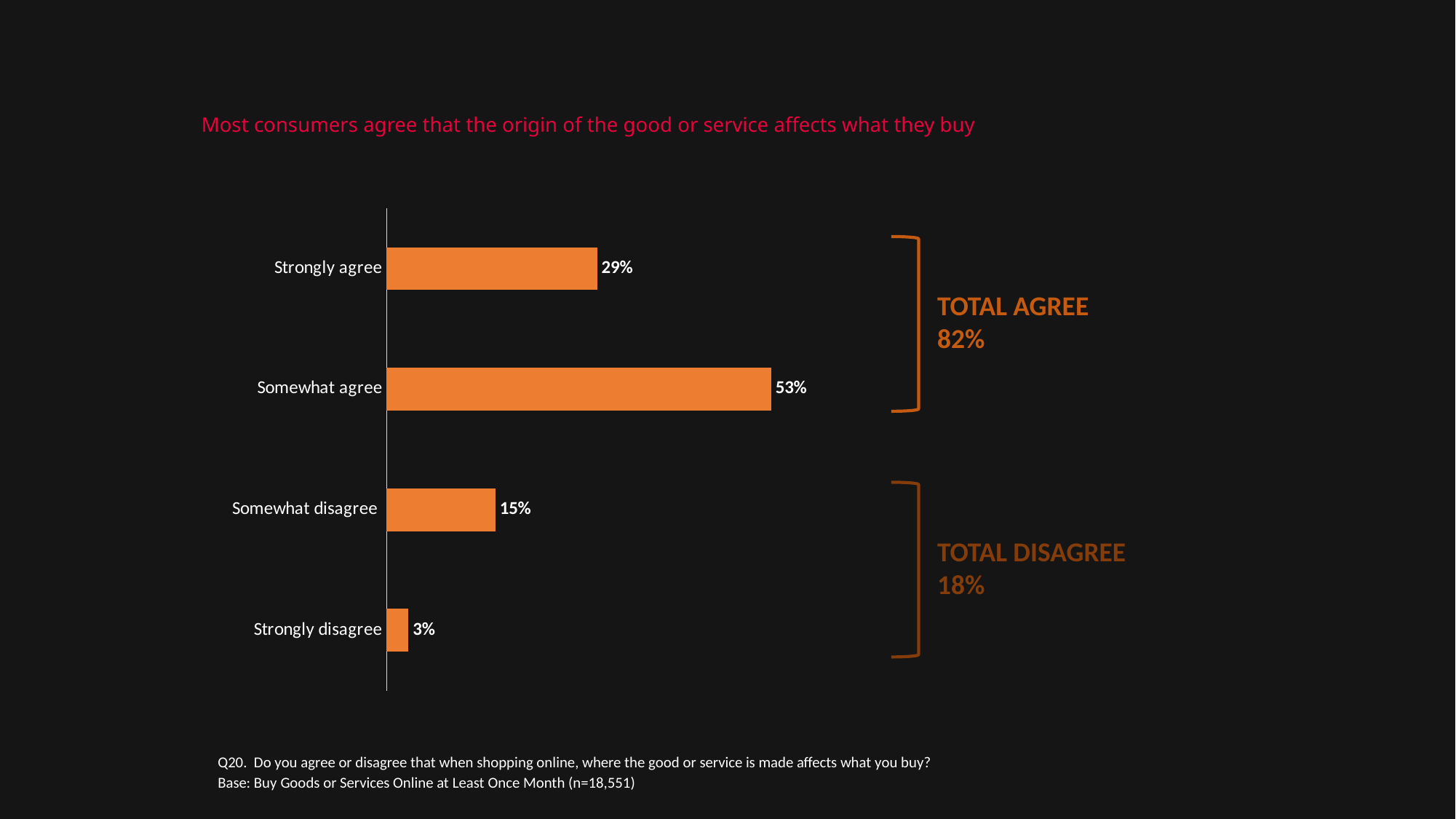
How many response categories are shown in the chart? 4 What is the Total Agree percentage shown on the slide? 82% What is the difference between the Somewhat disagree and Strongly disagree percentages? 12% Which is larger, the percentage for Strongly agree or for Somewhat disagree? Strongly agree What percentage of consumers strongly disagree? 3% What percentage of consumers strongly agree? 29% What kind of chart is shown on the slide? Bar chart What is the difference between the Somewhat agree and Strongly agree percentages? 24% Which response category has the lowest percentage? Strongly disagree What percentage of consumers somewhat agree? 53% What percentage of consumers somewhat disagree? 15% Which response category has the highest percentage? Somewhat agree